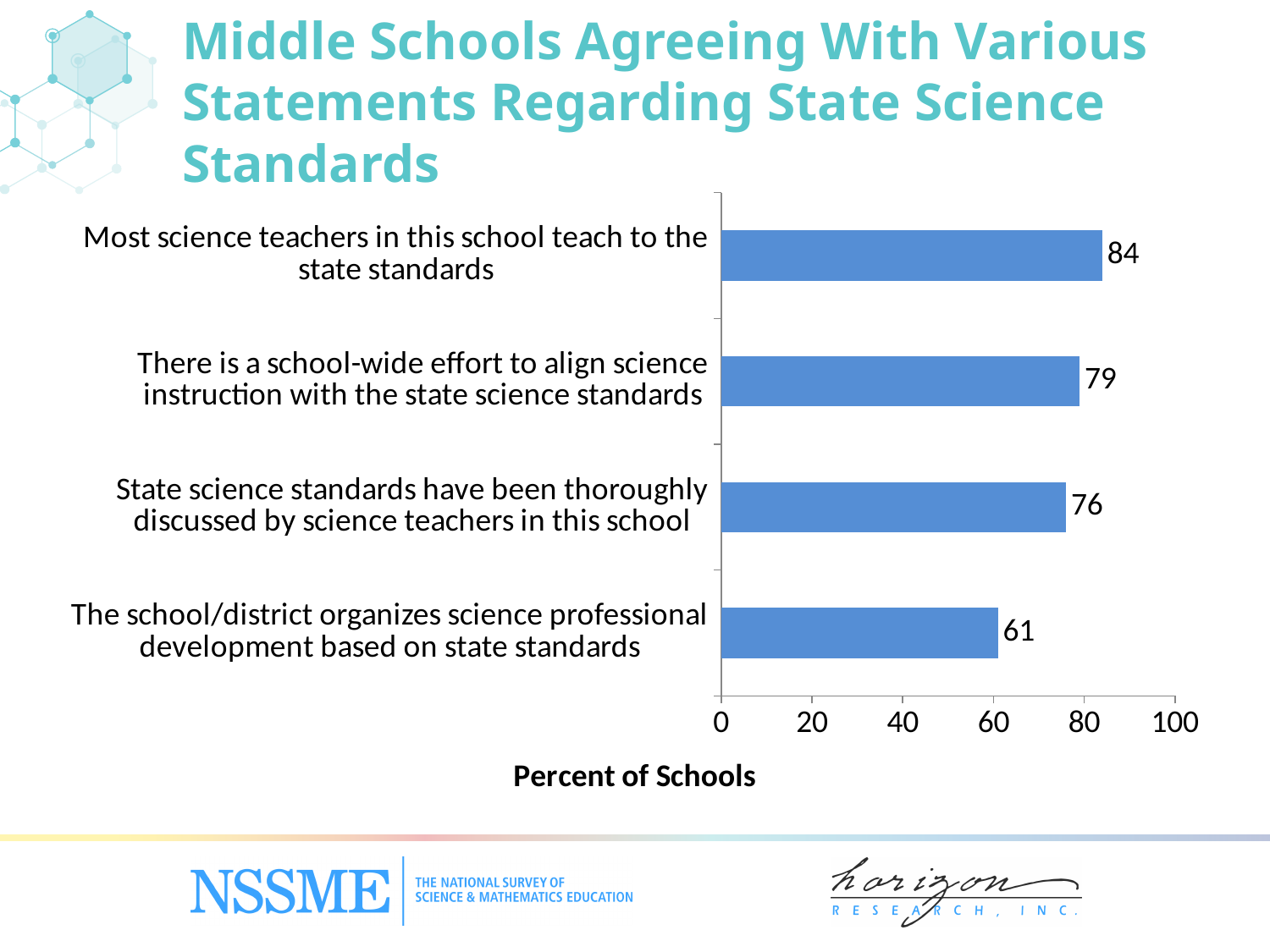
What is the label of the horizontal axis? Percent of Schools Which statement has the highest percent of schools agreeing? Most science teachers in this school teach to the state standards How many statements are shown in the chart? 4 What is the difference in percent of schools between the statement about most science teachers teaching to the state standards and the statement about the school/district organizing science professional development based on state standards? 23 Which statement has the lowest percent of schools agreeing? The school/district organizes science professional development based on state standards What percent of middle schools agree that there is a school-wide effort to align science instruction with the state science standards? 79 Is the value for the statement about the school/district organizing science professional development based on state standards greater or less than 80? less What kind of chart is shown on the slide? bar chart Which has a higher percent of schools agreeing: the school-wide effort to align science instruction statement or the state science standards thoroughly discussed statement? There is a school-wide effort to align science instruction with the state science standards What percent of middle schools agree that state science standards have been thoroughly discussed by science teachers in this school? 76 What percent of middle schools agree that most science teachers in this school teach to the state standards? 84 What percent of middle schools agree that the school/district organizes science professional development based on state standards? 61